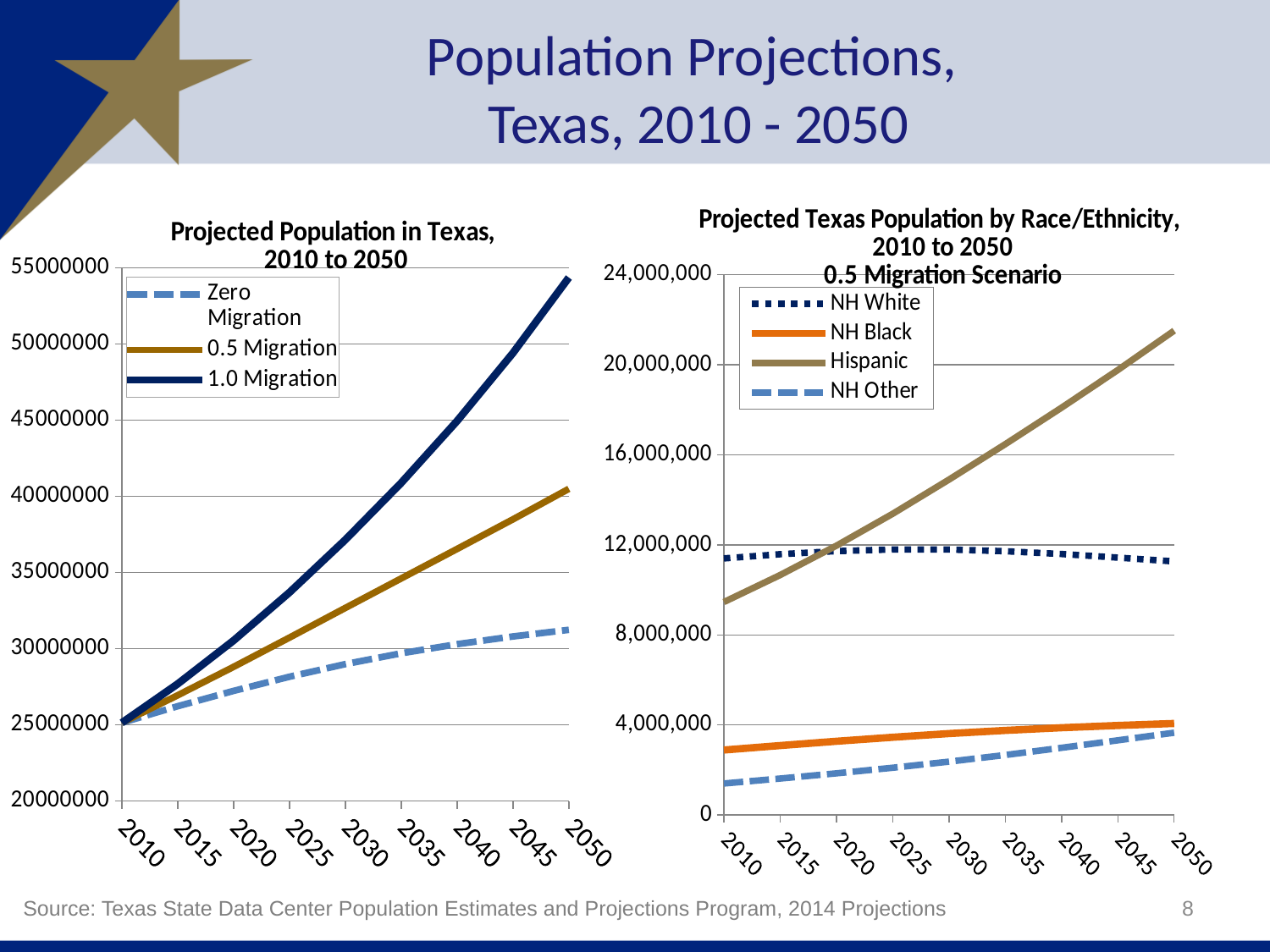
In the right chart, 'Projected Texas Population by Race/Ethnicity', is the value for Hispanic in 2050 greater or less than 20,000,000? greater How many year labels are shown on the x axis of the right chart, 'Projected Texas Population by Race/Ethnicity'? 9 In the left chart, 'Projected Population in Texas, 2010 to 2050', is the value for Zero Migration in 2050 greater or less than 30000000? greater In the right chart, 'Projected Texas Population by Race/Ethnicity', is the value for NH White in 2050 greater or less than 12,000,000? less How many series does the legend of the left chart, 'Projected Population in Texas, 2010 to 2050', list? 3 How many series does the legend of the right chart, 'Projected Texas Population by Race/Ethnicity', list? 4 What kind of chart is the left chart, 'Projected Population in Texas, 2010 to 2050'? line chart In the right chart, 'Projected Texas Population by Race/Ethnicity', which series has the lowest value in 2050? NH Other In the right chart, 'Projected Texas Population by Race/Ethnicity', which series has the highest value in 2050? Hispanic In the left chart, 'Projected Population in Texas, 2010 to 2050', which series is larger in 2050: 1.0 Migration or Zero Migration? 1.0 Migration In the right chart, 'Projected Texas Population by Race/Ethnicity', does the Hispanic series rise or fall from 2010 to 2050? rise